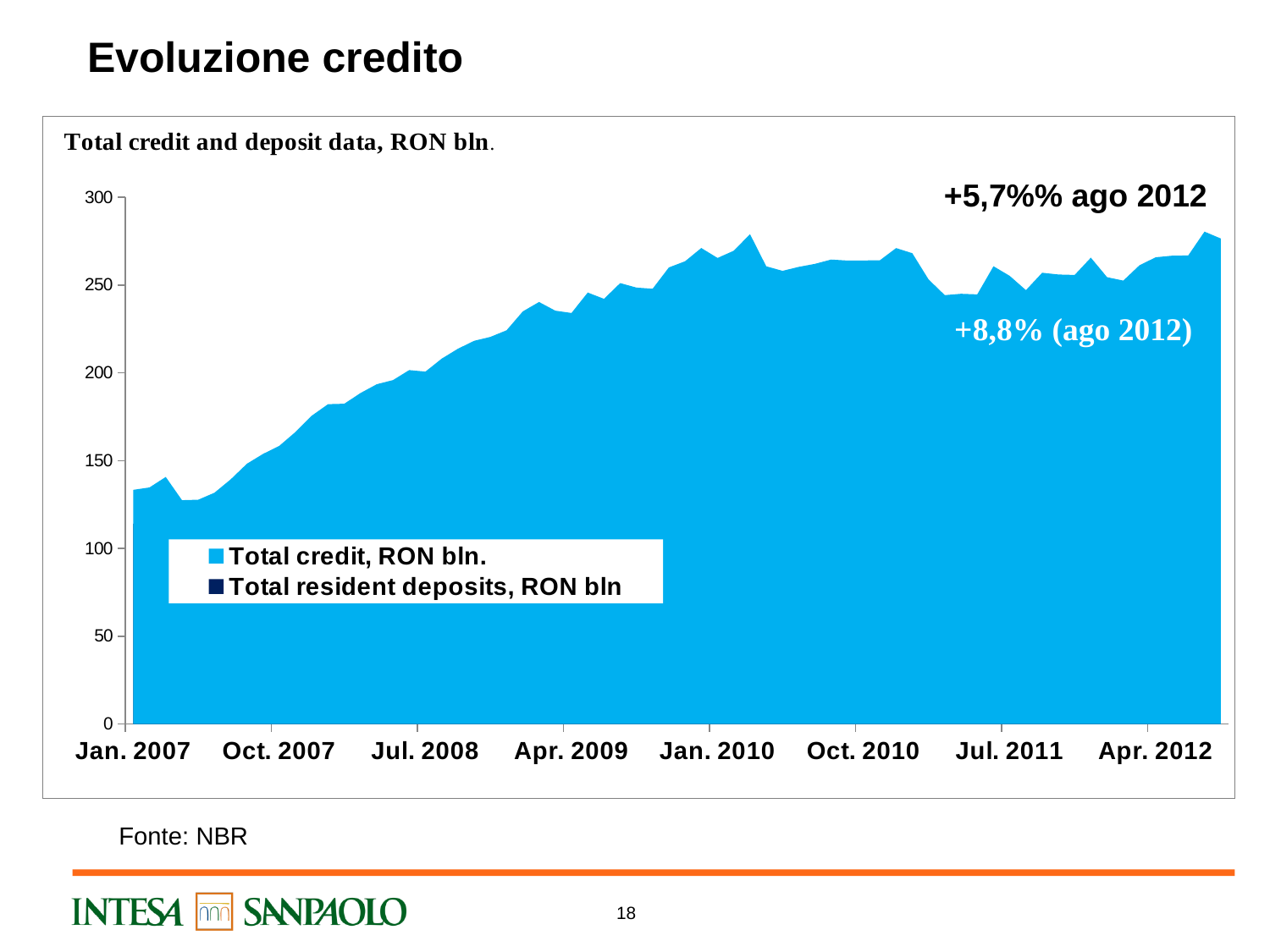
Is the value of total credit at Oct. 2007 greater or less than 200? less What kind of chart is shown on the slide? area chart How many series does the legend list? 2 Which is larger, total credit at Jan. 2007 or at Apr. 2012? Apr. 2012 Which two series are listed in the legend? Total credit, RON bln. and Total resident deposits, RON bln Is the value of total credit at Jan. 2007 greater or less than 150? less What is the title of the chart? Total credit and deposit data, RON bln. Is the value of total credit at Jan. 2010 greater or less than 250? greater Does total credit generally rise or fall from Jan. 2007 to Jan. 2010? rise What is the highest value shown on the vertical axis? 300